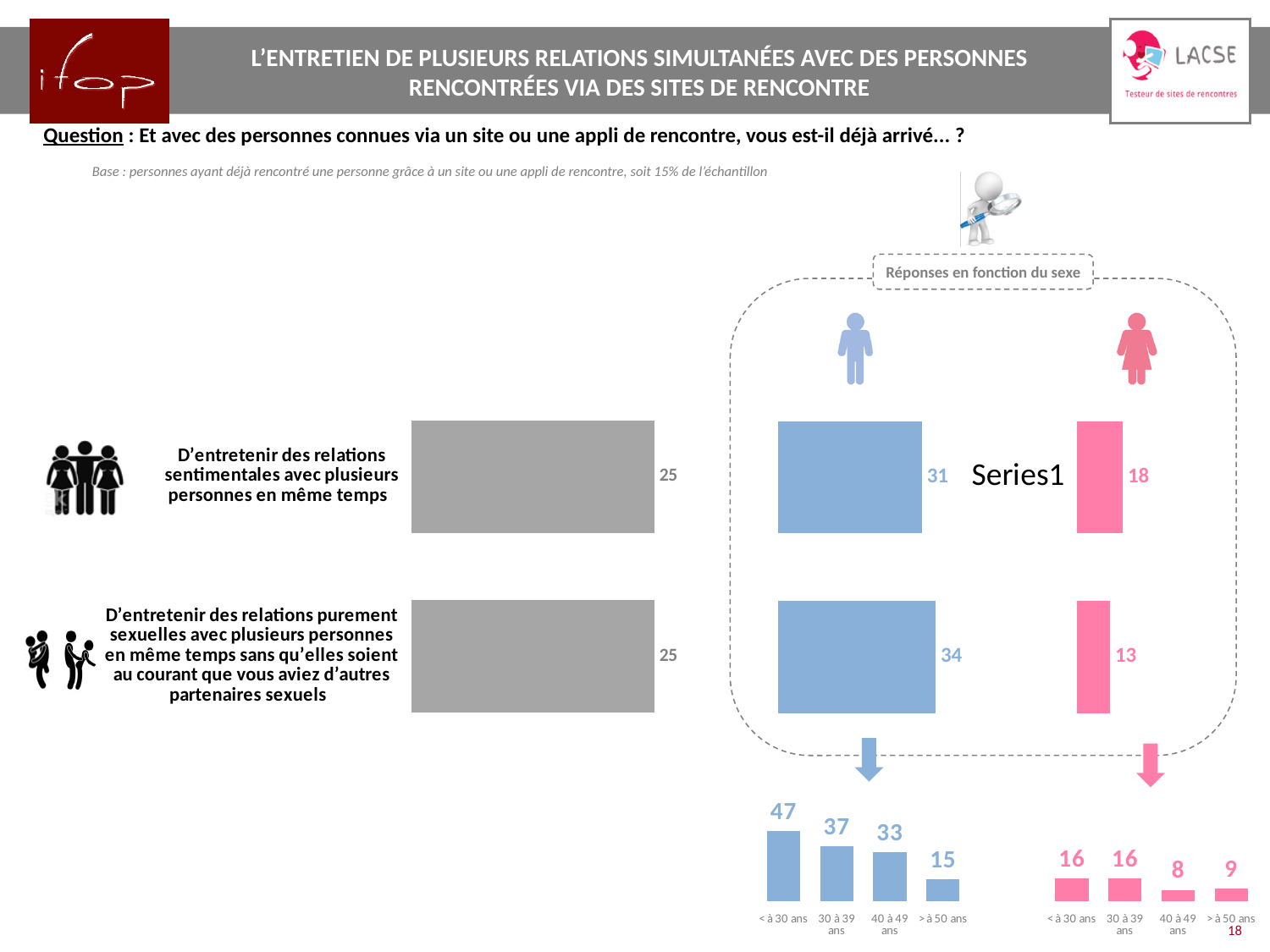
In the blue age-group bar chart at the bottom, what is the value for "> à 50 ans"? 15 In the Réponses en fonction du sexe section, what is the difference between the men's value (31) and the women's value (18) for "D'entretenir des relations sentimentales avec plusieurs personnes en même temps"? 13 In the grey bar chart on the left, what is the value for "D'entretenir des relations sentimentales avec plusieurs personnes en même temps"? 25 In the blue age-group bar chart at the bottom, do the values rise or fall from "< à 30 ans" to "> à 50 ans"? fall In the blue bar chart for men (Réponses en fonction du sexe), what is the value for "D'entretenir des relations purement sexuelles avec plusieurs personnes en même temps sans qu'elles soient au courant que vous aviez d'autres partenaires sexuels"? 34 In the blue age-group bar chart at the bottom, which age group has the highest value? < à 30 ans What type of chart is the blue age-group chart at the bottom of the slide? bar chart In the pink age-group bar chart at the bottom, what is the value for "30 à 39 ans"? 16 How many age groups are shown in the blue age-group bar chart at the bottom? 4 In the pink bar chart for women (Réponses en fonction du sexe), what is the value for "D'entretenir des relations sentimentales avec plusieurs personnes en même temps"? 18 In the pink age-group bar chart at the bottom, which age group has the lowest value? 40 à 49 ans In the Réponses en fonction du sexe section, for "D'entretenir des relations purement sexuelles...", which is larger: the men's value or the women's value? the men's value